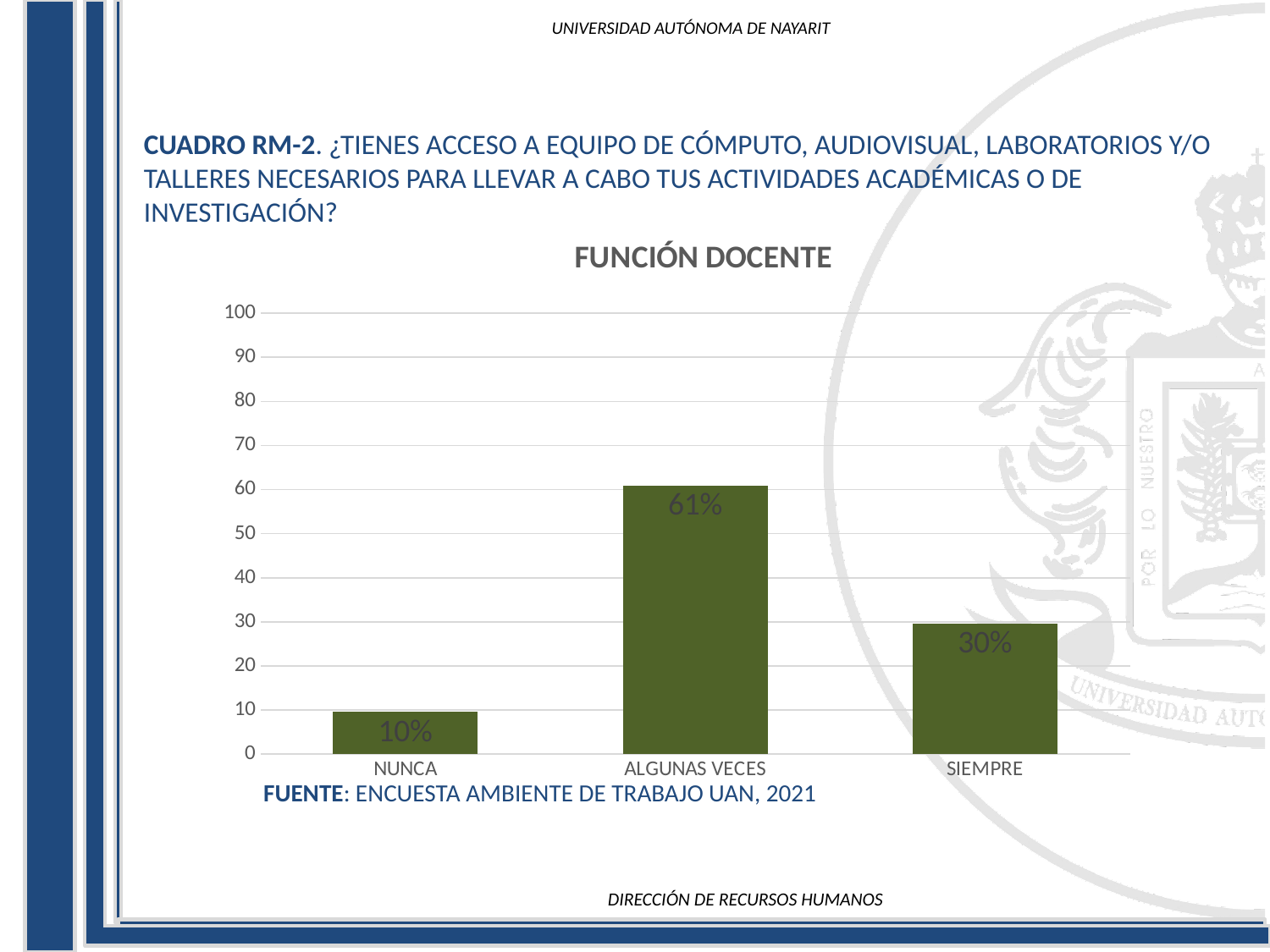
What kind of chart is shown on the slide? bar chart What is the difference between the values for ALGUNAS VECES and SIEMPRE? 31% What is the value for NUNCA? 10% What is the title of the chart? FUNCIÓN DOCENTE Is the value for ALGUNAS VECES greater or less than 50? greater Which category has the highest value? ALGUNAS VECES How many categories are shown on the x axis? 3 Which is larger, the value for SIEMPRE or the value for NUNCA? SIEMPRE What is the difference between the values for SIEMPRE and NUNCA? 20% What is the value for SIEMPRE? 30% What is the value for ALGUNAS VECES? 61% Which category has the lowest value? NUNCA